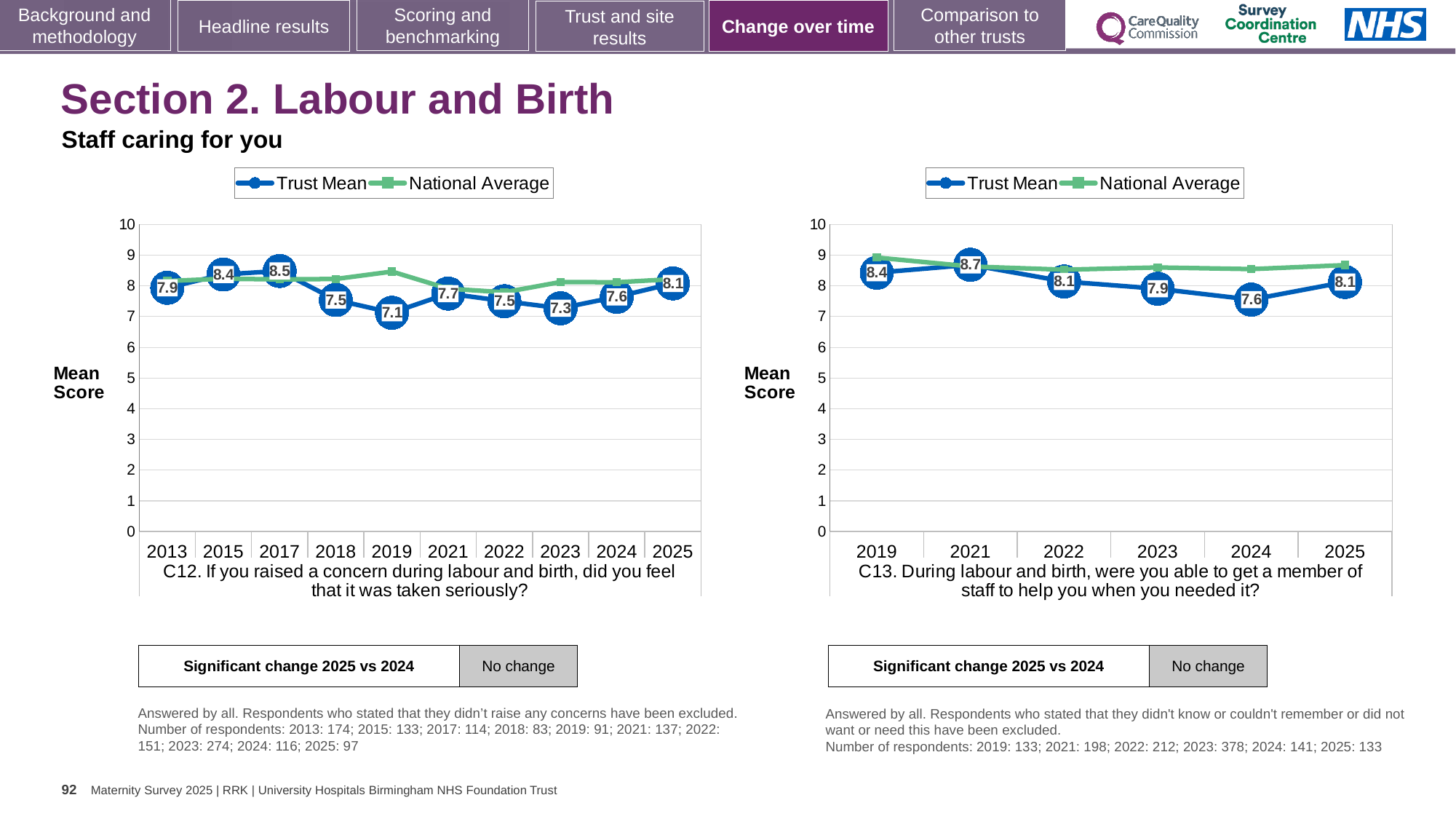
In the C13 chart on the right, what is the Trust Mean score for 2024? 7.6 In the C12 chart on the left, how many years are plotted on the x axis? 10 In the C12 chart on the left, which year has the lowest Trust Mean score? 2019 In the C13 chart on the right, is the National Average value for 2019 greater or less than 8? greater In the C13 chart on the right, is the Trust Mean score for 2021 larger or smaller than the score for 2025? larger In the C13 chart on the right, how many series does the legend list? 2 In the C12 chart on the left, which year has the highest Trust Mean score? 2017 In the C13 chart on the right, does the Trust Mean score rise or fall from 2021 to 2024? fall In the C12 chart on the left, what is the difference between the Trust Mean scores for 2017 and 2018? 1.0 In the C12 chart on the left, what is the Trust Mean score for 2019? 7.1 What kind of chart is the C13 chart on the right? Line chart In the C13 chart on the right, which year has the highest Trust Mean score? 2021